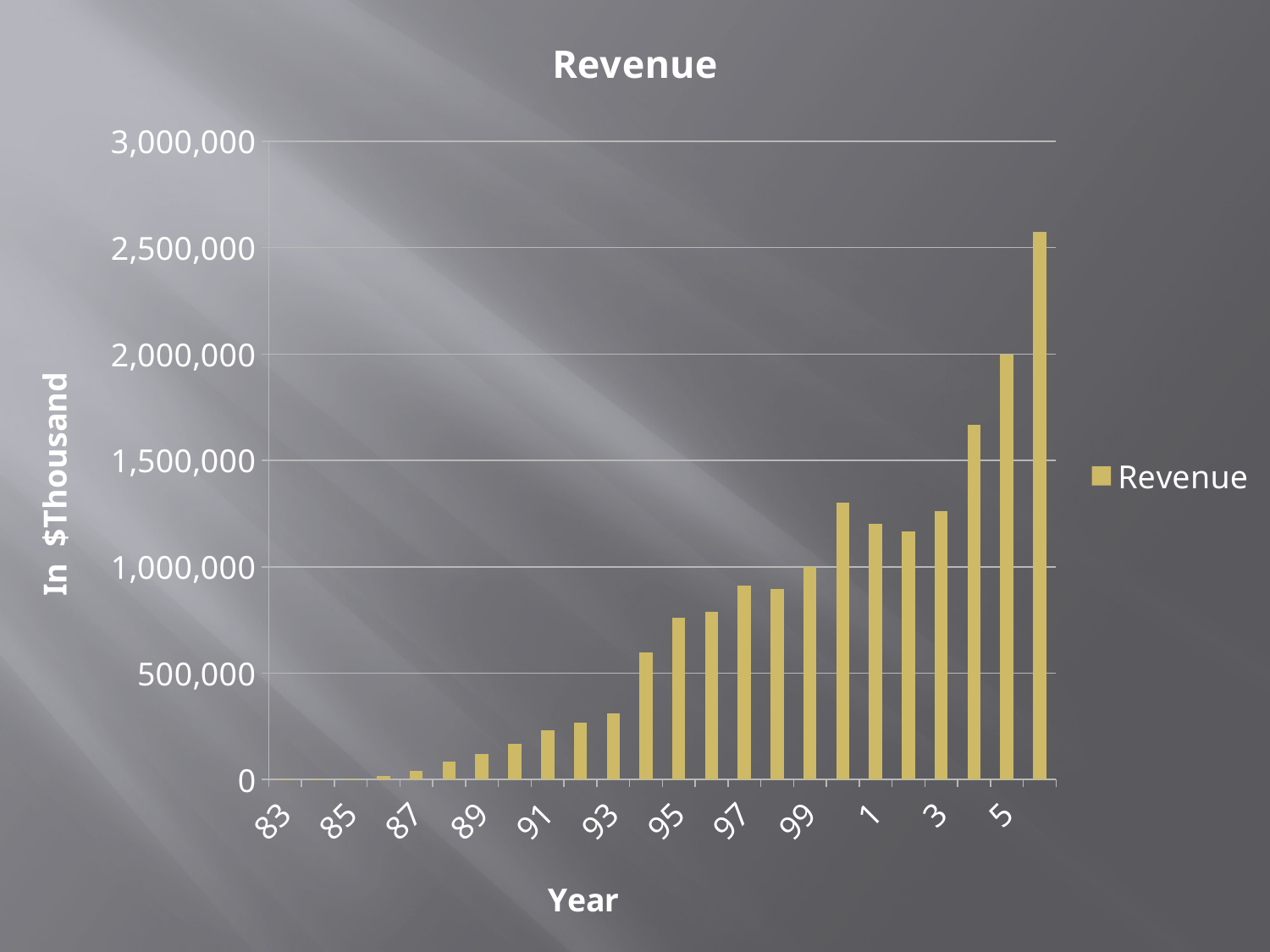
Is the value for year 93 greater or less than 500,000? less Which has the larger revenue, year 99 or year 97? 99 Which has the larger revenue, year 95 or year 93? 95 Is the value for year 97 greater or less than 1,000,000? less Do the revenue values generally rise or fall from left to right along the x axis? Rise What is the title of the chart? Revenue Is the value for year 1 greater or less than 1,000,000? greater How many series does the legend list? 1 What is the label on the vertical axis of the chart? In $Thousand What type of chart is shown on the slide? Bar chart